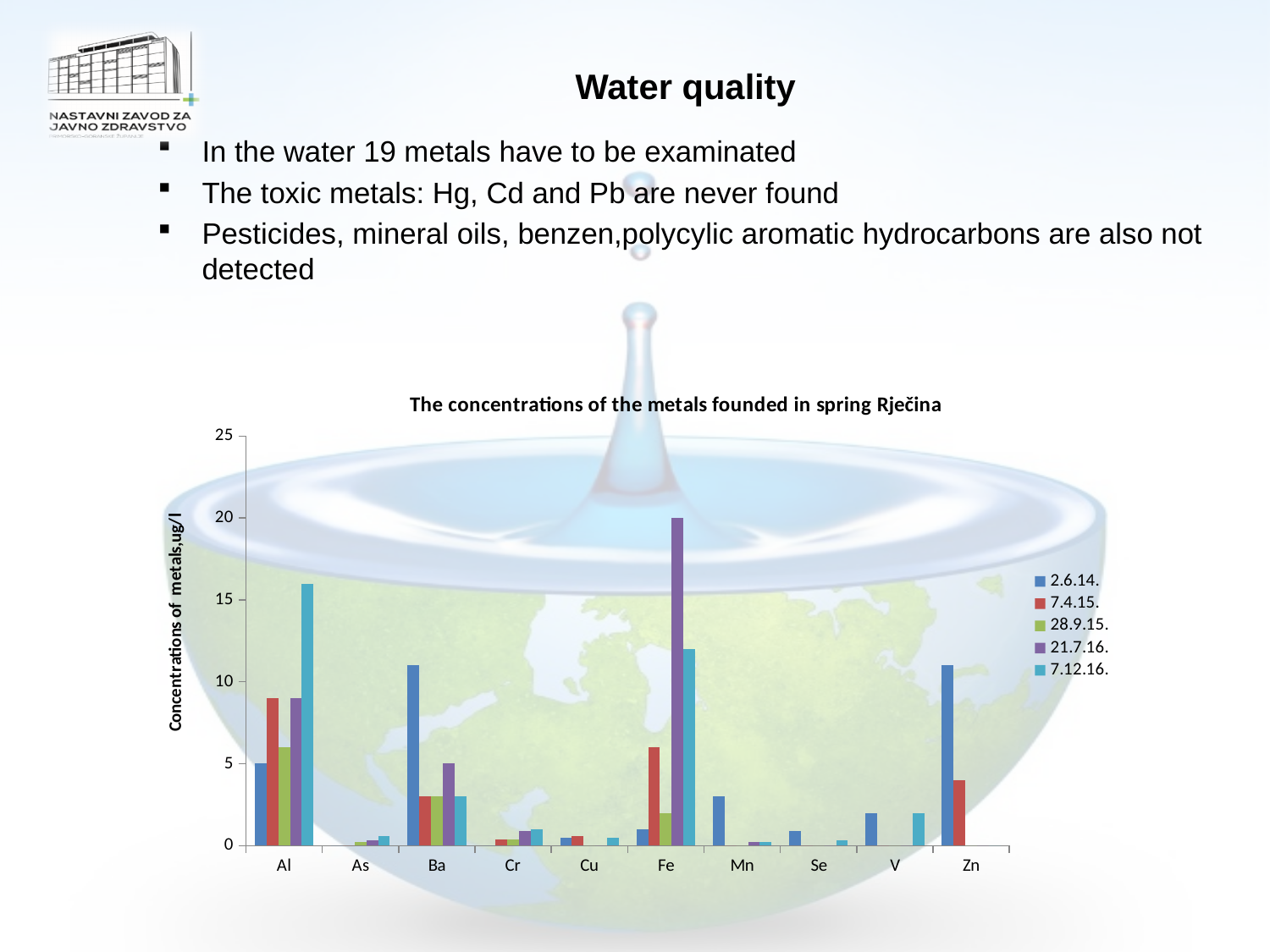
Is the value for Zn on 2.6.14. greater or less than 10? greater What is the title of the chart? The concentrations of the metals founded in spring Rječina What kind of chart is shown on the slide? bar chart Is the value for Al on 7.12.16. greater or less than 15? greater For Al, which date has the larger value: 2.6.14. or 7.4.15.? 7.4.15. Is the value for Fe on 7.12.16. greater or less than 10? greater What is the label of the vertical axis of the chart? Concentrations of metals,ug/l What is the concentration of Fe on 21.7.16.? 20 Which metal has the tallest bar in the chart? Fe How many metals are listed along the x axis of the chart? 10 How many sampling dates does the chart legend list? 5 For Fe, which date has the larger value: 21.7.16. or 7.12.16.? 21.7.16.